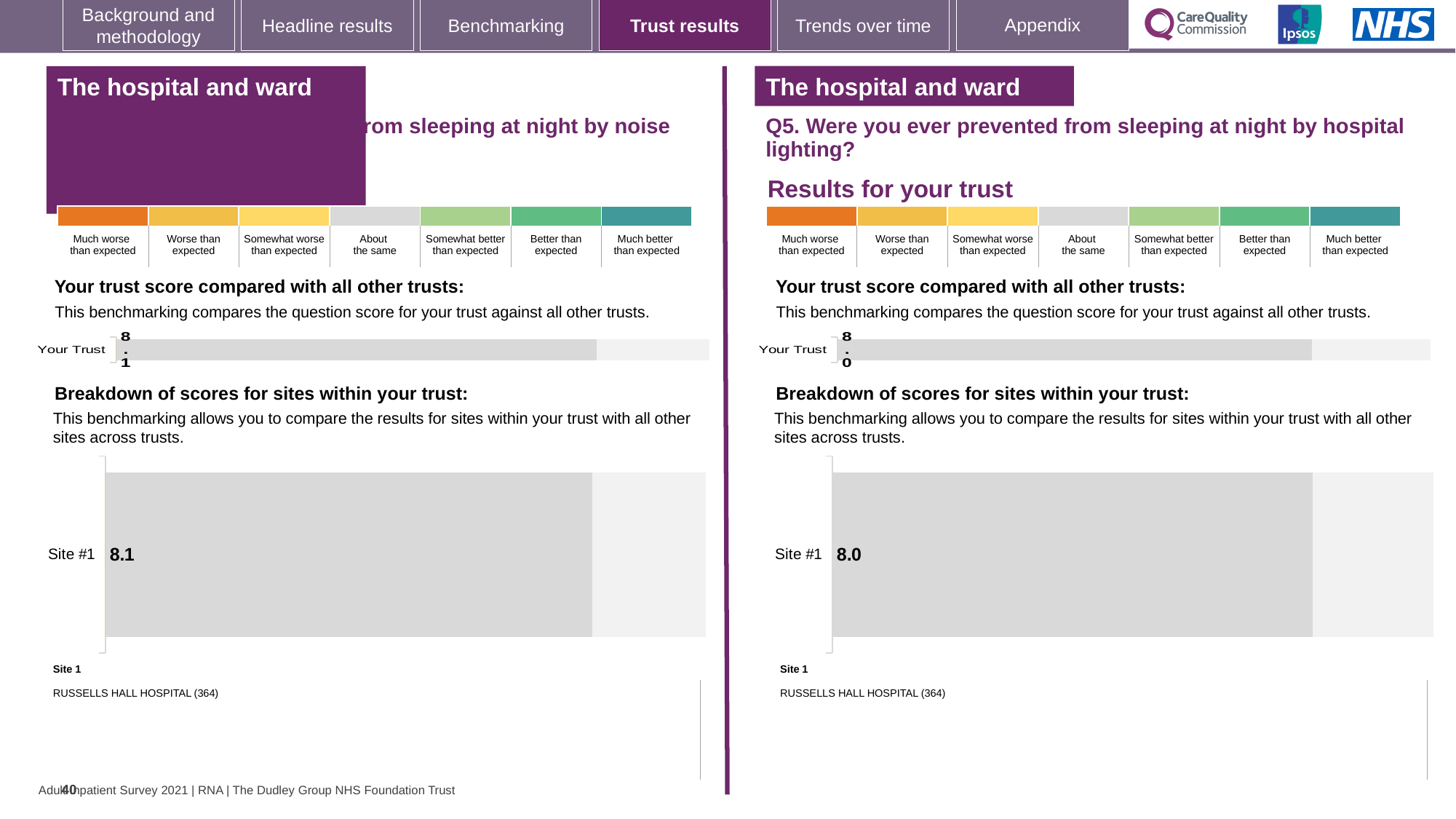
How many sites are shown in the right 'Breakdown of scores for sites within your trust' chart (Q5)? 1 How many rating categories are shown in the colour key above the Q5 chart on the right half of the slide? 7 Which is larger: the Your Trust score on the left half of the slide (noise) or the Your Trust score on the right half (Q5, hospital lighting)? Left (noise), 8.1 What is the difference between the Site #1 score on the left half of the slide (noise) and the Site #1 score on the right half (Q5, hospital lighting)? 0.1 In the right 'Breakdown of scores for sites within your trust' chart (Q5), what is the score for Site #1? 8.0 On the right half of the slide (Q5, hospital lighting), what is the score shown for Your Trust? 8.0 On the left half of the slide (sleeping at night by noise), what is the score shown for Your Trust? 8.1 What type of chart is used to show the Your Trust score on the right half of the slide (Q5)? Bar chart Which hospital is listed as Site 1 on the right half of the slide (Q5)? RUSSELLS HALL HOSPITAL (364) In the left 'Breakdown of scores for sites within your trust' chart, what is the score for Site #1? 8.1